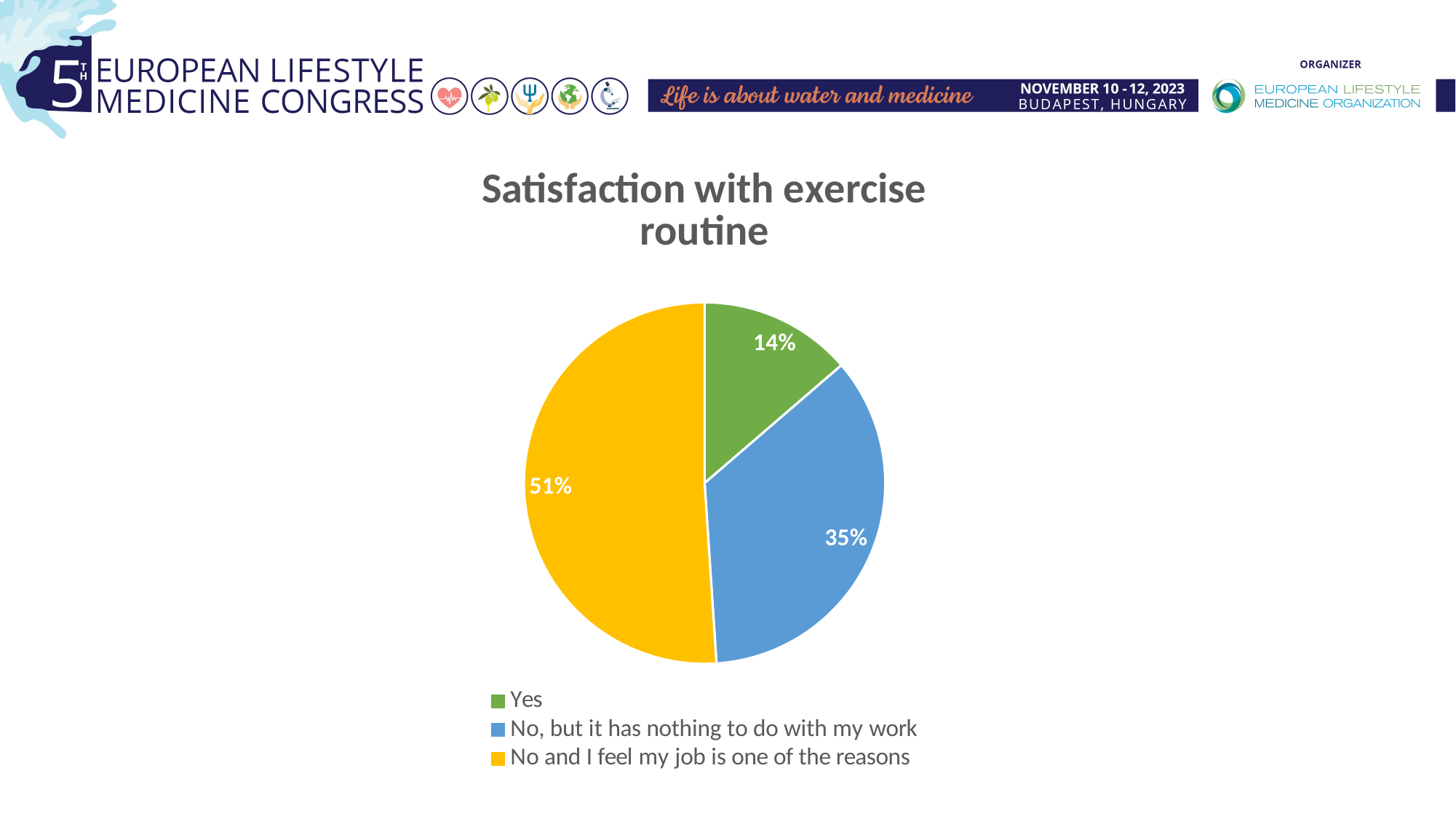
Which category has the smallest share of the pie? Yes How many categories does the pie chart show? 3 What percentage of respondents answered "Yes"? 14% What is the combined share of the two "No" categories? 86% What is the title of the chart? Satisfaction with exercise routine What percentage of respondents answered "No, but it has nothing to do with my work"? 35% What type of chart is shown on the slide? Pie chart Which is larger: the share for "No, but it has nothing to do with my work" or the share for "Yes"? No, but it has nothing to do with my work What colour is the slice for "Yes"? Green What is the difference in percentage points between "No and I feel my job is one of the reasons" and "Yes"? 37 percentage points What percentage of respondents answered "No and I feel my job is one of the reasons"? 51% Which category has the largest share of the pie? No and I feel my job is one of the reasons